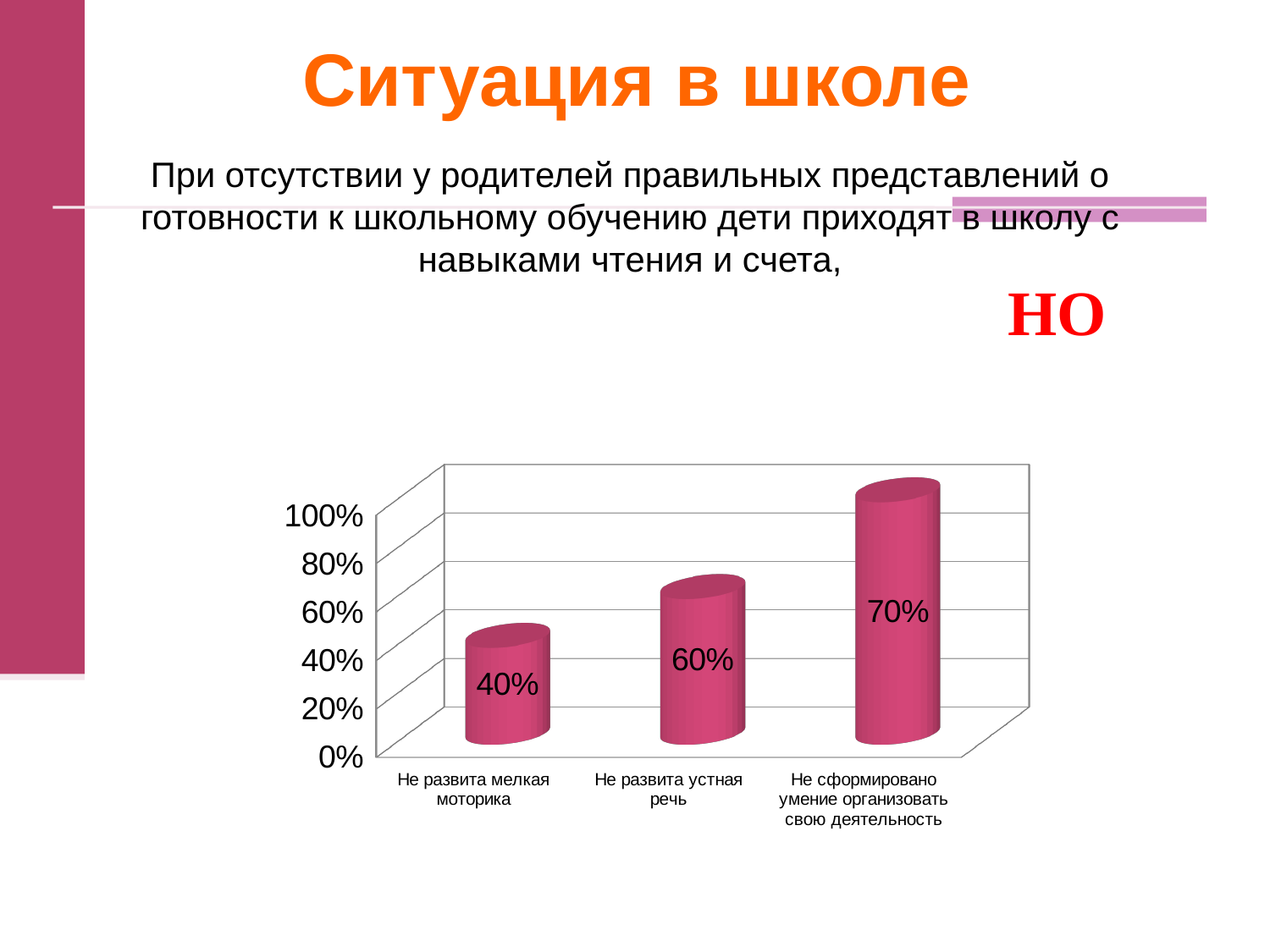
What is the difference between the values for "Не развита устная речь" and "Не развита мелкая моторика"? 20% What is the value for "Не сформировано умение организовать свою деятельность"? 70% What is the difference between the values for "Не сформировано умение организовать свою деятельность" and "Не развита мелкая моторика"? 30% How many categories are shown in the chart? 3 What is the highest value shown on the vertical axis? 100% Which category has the lowest value? Не развита мелкая моторика Do the values rise or fall from left to right across the categories? Rise Which is larger: the value for "Не развита устная речь" or for "Не развита мелкая моторика"? Не развита устная речь What is the value for "Не развита устная речь"? 60% What kind of chart is shown on the slide? Bar chart What is the value for "Не развита мелкая моторика"? 40% Which category has the highest value? Не сформировано умение организовать свою деятельность